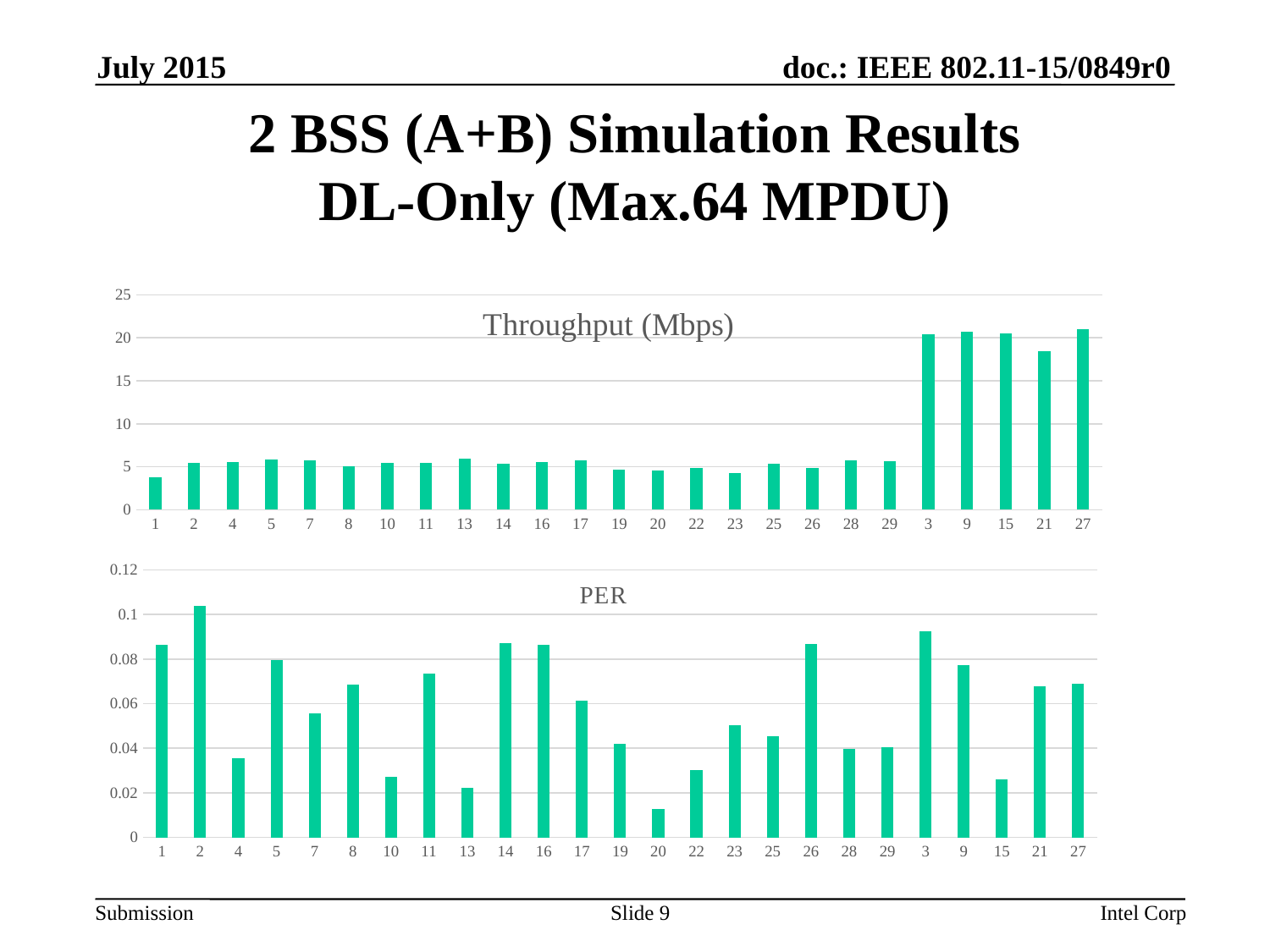
In the PER chart, which category has the highest PER? 2 In the Throughput (Mbps) chart, which has the larger value, category 3 or category 1? 3 In the Throughput (Mbps) chart, is the value for category 1 greater or less than 5? less In the Throughput (Mbps) chart, is the value for category 3 greater or less than 15? greater What kind of chart is the Throughput (Mbps) chart? bar chart In the Throughput (Mbps) chart, which category has the lowest throughput? 1 How many categories are shown on the x axis of the PER chart? 25 In the PER chart, which category has the lowest PER? 20 In the PER chart, is the value for category 20 greater or less than 0.02? less In the PER chart, which has the larger value, category 2 or category 4? 2 What is the title of the top chart on the slide? Throughput (Mbps)